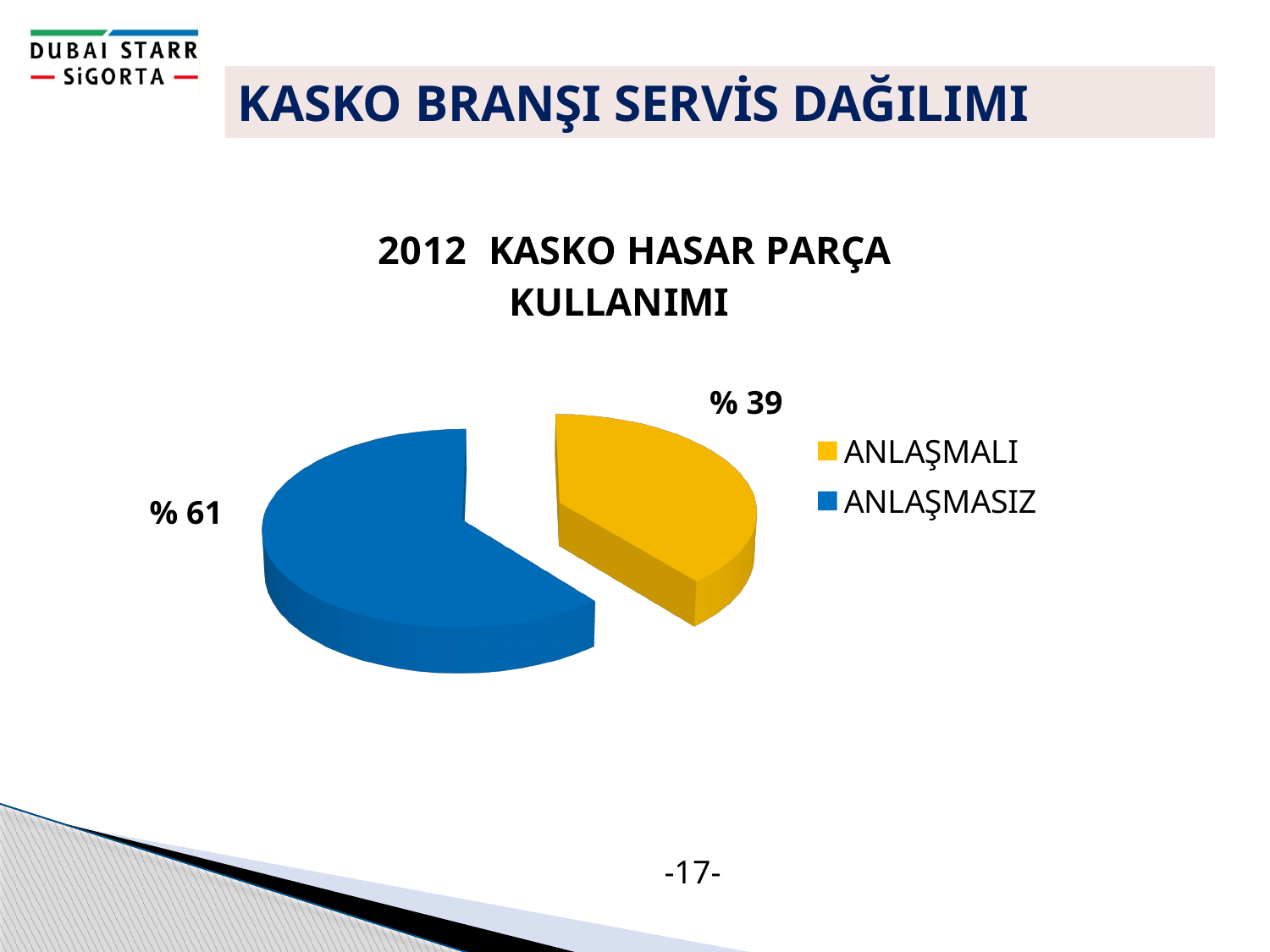
How many slices does the pie chart have? 2 What is the value shown for ANLAŞMASIZ? % 61 Which is larger, the share for ANLAŞMALI or the share for ANLAŞMASIZ? ANLAŞMASIZ How many entries does the legend list? 2 What is the value shown for ANLAŞMALI? % 39 Which category has the smallest share of the pie? ANLAŞMALI What is the difference in percentage points between ANLAŞMASIZ and ANLAŞMALI? 22 Which category has the largest share of the pie? ANLAŞMASIZ What colour is the ANLAŞMALI slice? yellow What kind of chart is shown on the slide? pie chart What is the title of the chart? 2012 KASKO HASAR PARÇA KULLANIMI What share of the pie does ANLAŞMASIZ represent? % 61